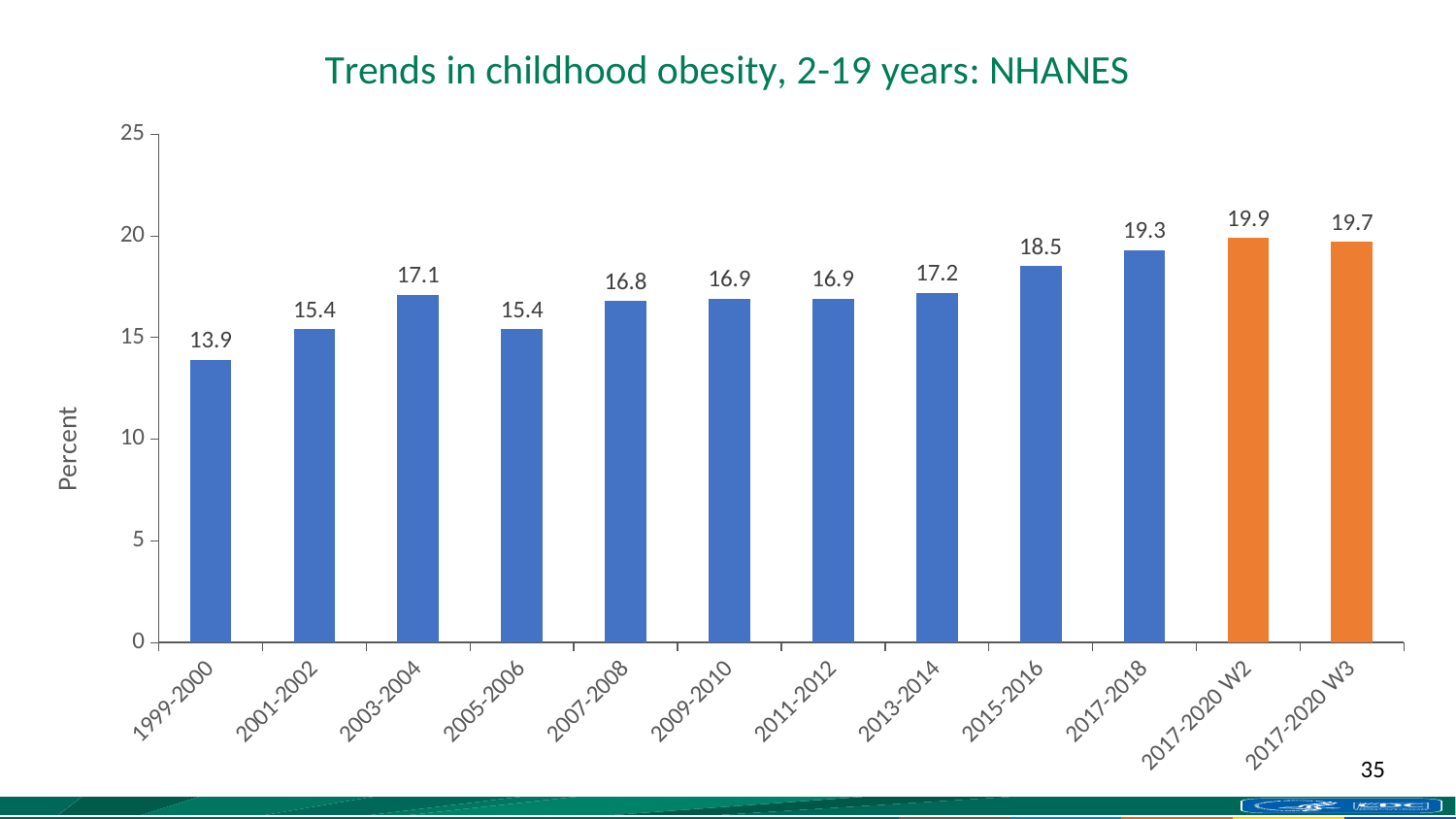
What is the difference between the values for 2017-2020 W2 and 1999-2000? 6 Do the values generally rise or fall from 1999-2000 to 2017-2020 W2? rise Is the value for 2017-2018 greater or less than 20? less What is the value for 2017-2020 W2? 19.9 Which period has the highest value? 2017-2020 W2 What kind of chart is this? bar chart Which is larger, the value for 2003-2004 or the value for 2005-2006? 2003-2004 What is the value for 1999-2000? 13.9 How many periods are shown on the x axis? 12 What is the value for 2015-2016? 18.5 Which period has the lowest value? 1999-2000 What is the title of the chart? Trends in childhood obesity, 2-19 years: NHANES